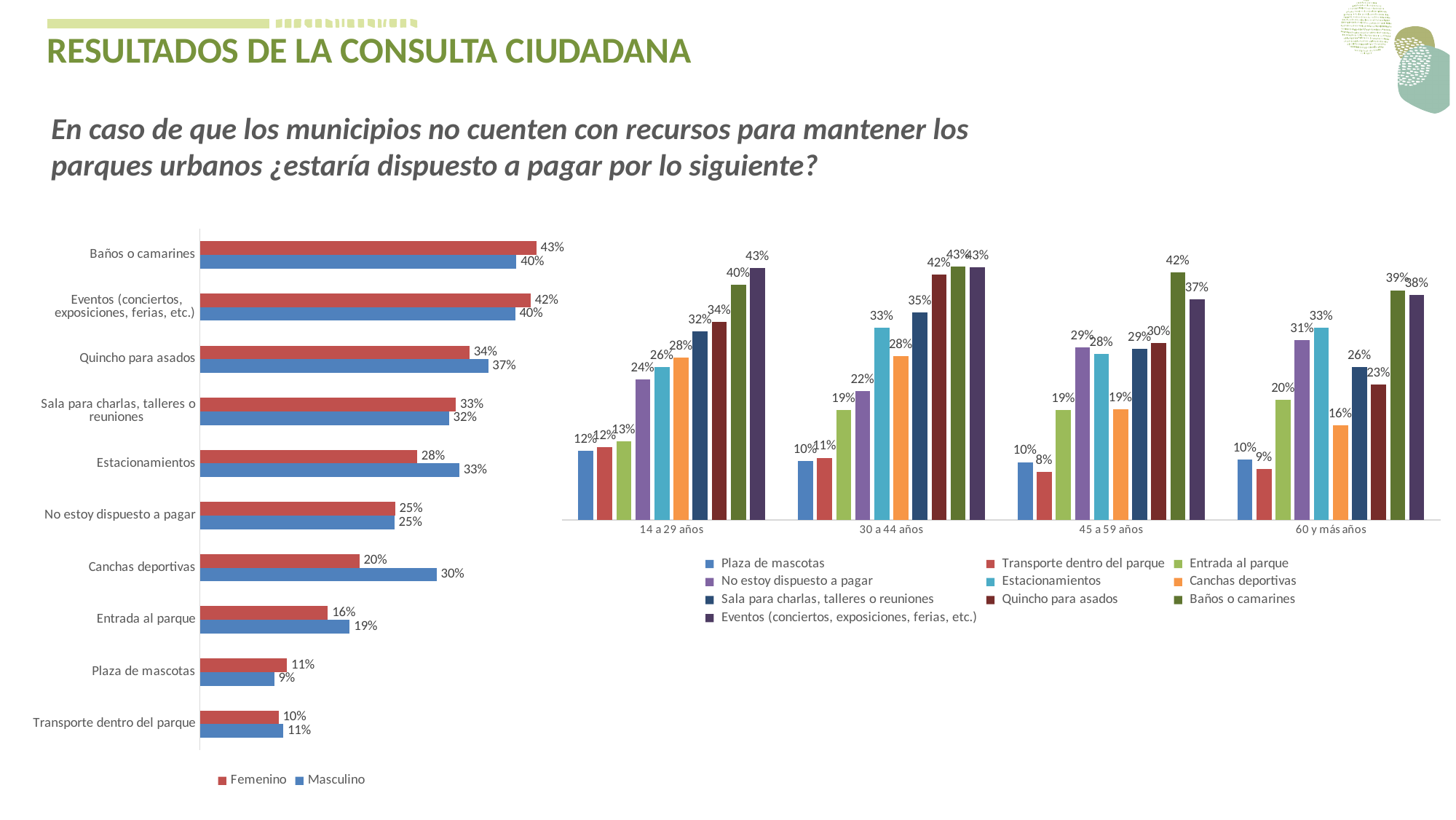
On the left chart (by gender), how many series does the legend list? 2 What type of chart is the chart on the right of the slide? Bar chart On the right chart (by age group), which series has the highest value in the 14 a 29 años group? Eventos (conciertos, exposiciones, ferias, etc.) On the left chart (by gender), how many categories are shown? 10 On the left chart (by gender), which category has the lowest Masculino value? Plaza de mascotas On the left chart (by gender), what is the difference between the Masculino and Femenino values for Canchas deportivas? 10% On the right chart (by age group), what is the value for Estacionamientos in the 30 a 44 años group? 33% On the right chart (by age group), what is the value for Baños o camarines in the 45 a 59 años group? 42% On the right chart (by age group), how many series does the legend list? 10 On the left chart (by gender), what is the Masculino value for Canchas deportivas? 30% On the left chart (by gender), what is the Femenino value for Baños o camarines? 43% On the right chart (by age group), is the value for Canchas deportivas larger in the 14 a 29 años group or the 60 y más años group? 14 a 29 años